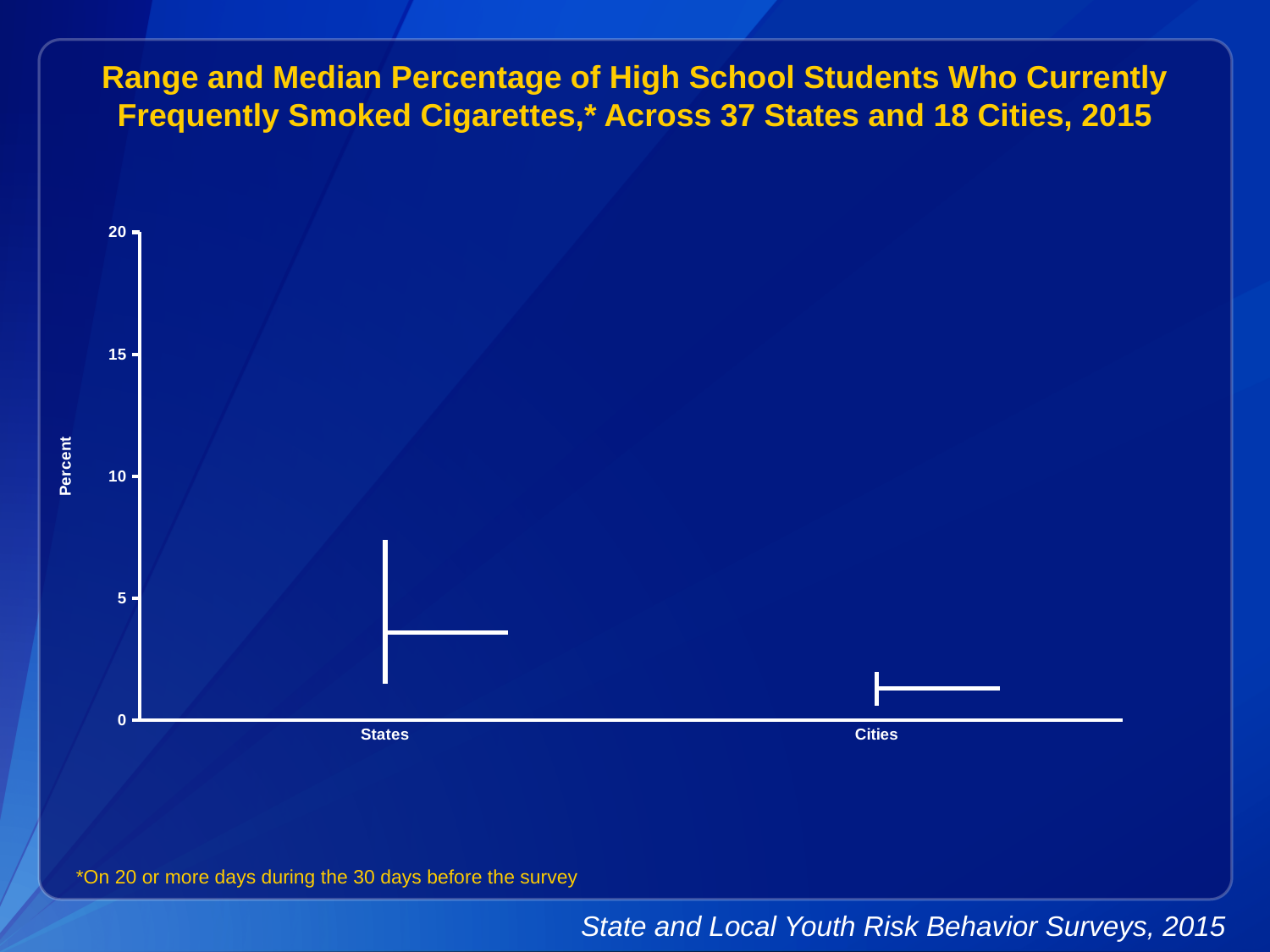
What is the highest value shown on the vertical axis? 20 What is the title of the chart? Range and Median Percentage of High School Students Who Currently Frequently Smoked Cigarettes,* Across 37 States and 18 Cities, 2015 Is the top of the range for States greater or less than 10? less Which category shows the wider range of percentages? States Which category has the lower median percentage? Cities Is the median value for Cities greater or less than 5? less Is the top of the range for States greater or less than 5? greater Which category has the higher median percentage, States or Cities? States What is the label on the vertical axis? Percent How many categories are shown on the x axis? 2